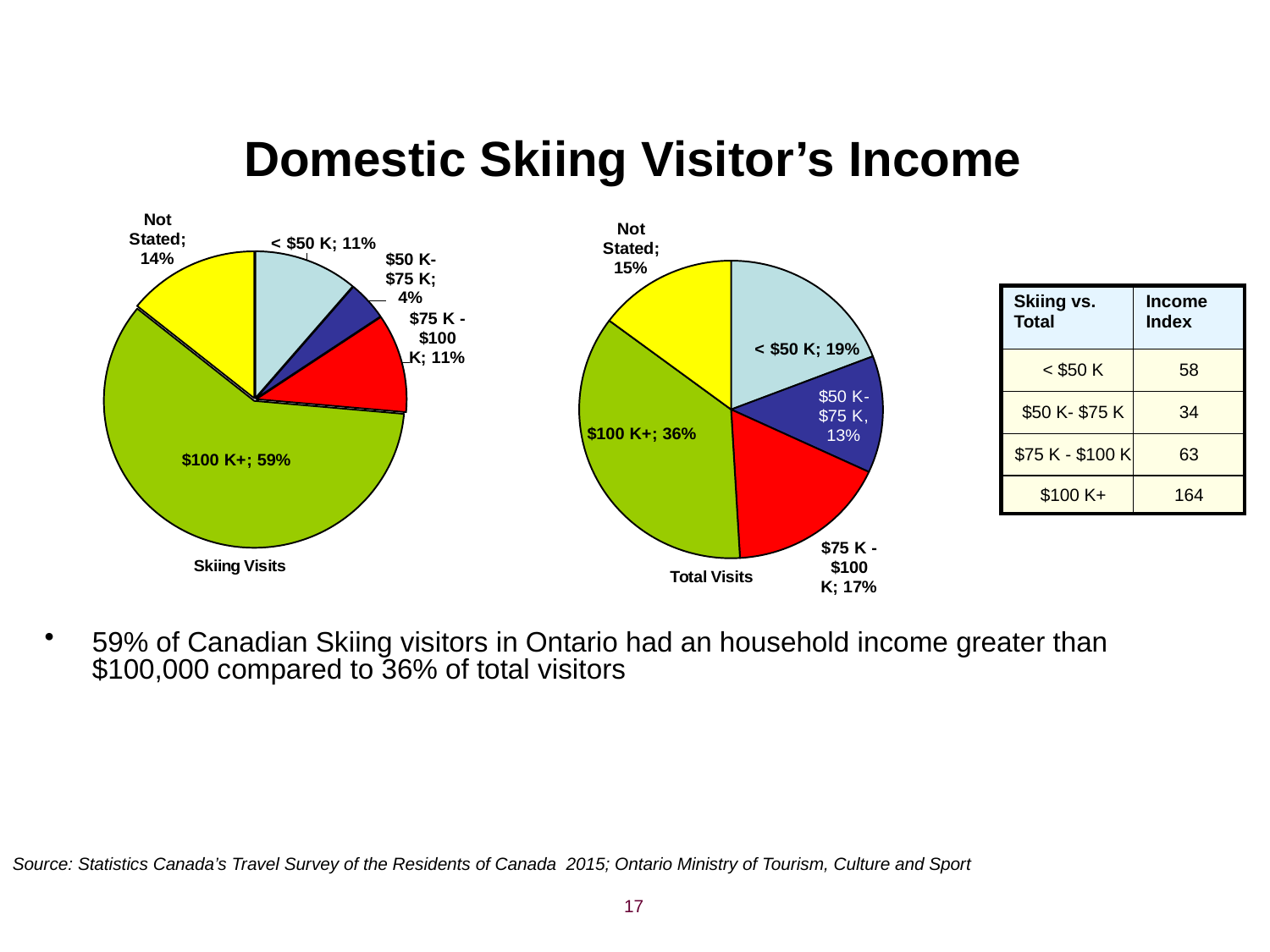
Which is larger: the Not Stated share in the Skiing Visits chart or the Not Stated share in the Total Visits chart? Total Visits In the Total Visits pie chart, which income category has the smallest slice? $50 K-$75 K In the Skiing Visits pie chart, what share of visitors had an income of $50 K-$75 K? 4% In the Total Visits pie chart, what share of visitors had an income of < $50 K? 19% In the Skiing Visits pie chart, which income category has the largest slice? $100 K+ In the Skiing Visits pie chart, what share of visitors had an income of $100 K+? 59% What type of chart is used to show the Total Visits income breakdown? Pie chart In the Total Visits pie chart, what share of visitors had an income of $100 K+? 36% In the Total Visits pie chart, what share of visitors had an income of $75 K - $100 K? 17% What is the difference between the $100 K+ share in the Skiing Visits chart and the $100 K+ share in the Total Visits chart? 23 percentage points How many slices does the Skiing Visits pie chart have? 5 In the Skiing Visits pie chart, which income category has the smallest slice? $50 K-$75 K